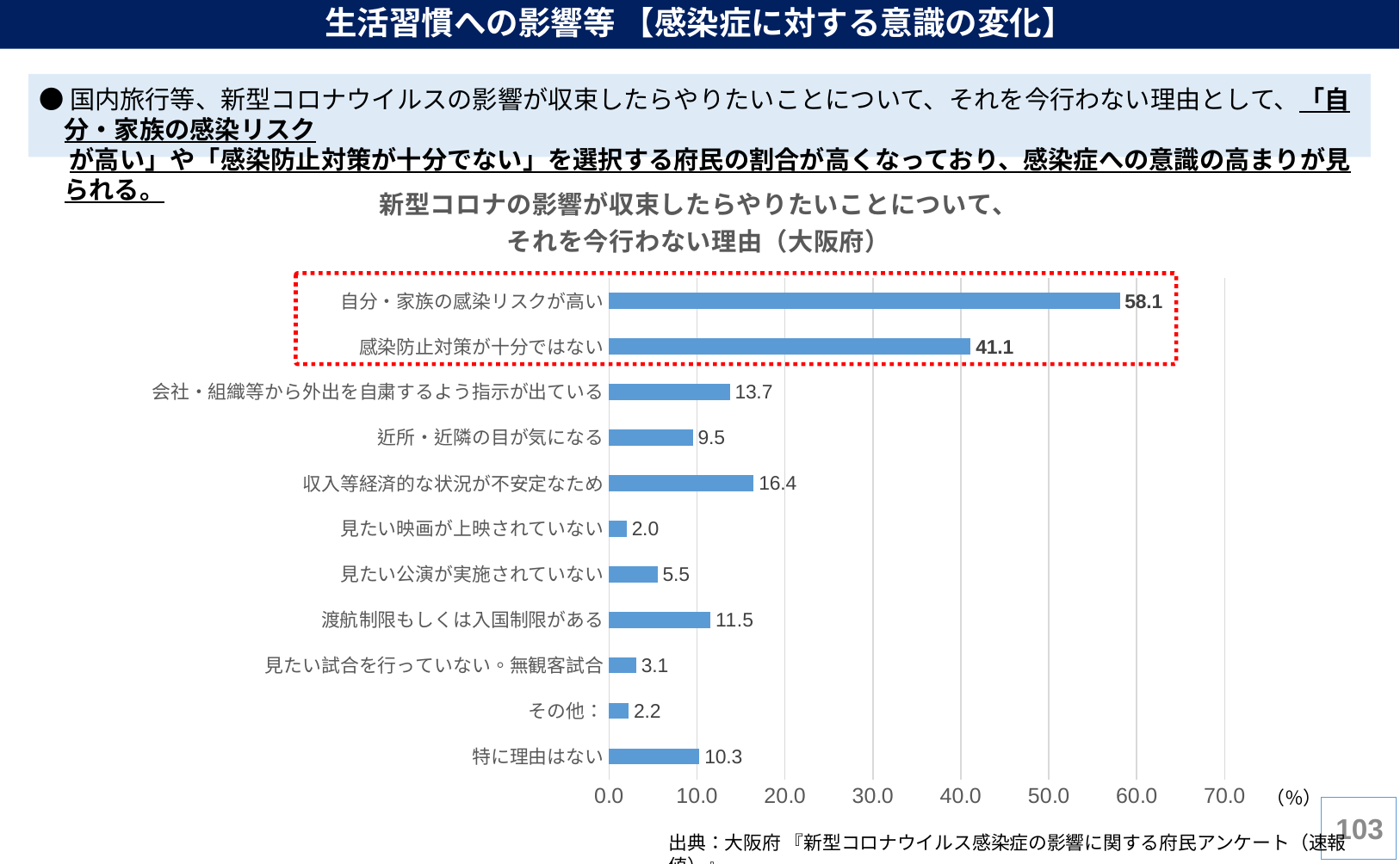
Which category has the highest value? 自分・家族の感染リスクが高い Which category has the lowest value? 見たい映画が上映されていない What unit is shown at the end of the horizontal axis? (%) Which is larger, the value for 渡航制限もしくは入国制限がある or the value for 近所・近隣の目が気になる? 渡航制限もしくは入国制限がある What is the difference between the values for 自分・家族の感染リスクが高い and 感染防止対策が十分ではない? 17.0 What is the value for 収入等経済的な状況が不安定なため? 16.4 How many categories are shown in the chart? 11 What is the value for 自分・家族の感染リスクが高い? 58.1 What is the value for 特に理由はない? 10.3 What is the difference between the values for 会社・組織等から外出を自粛するよう指示が出ている and 見たい公演が実施されていない? 8.2 What kind of chart is shown on the slide? Bar chart What is the value for 感染防止対策が十分ではない? 41.1